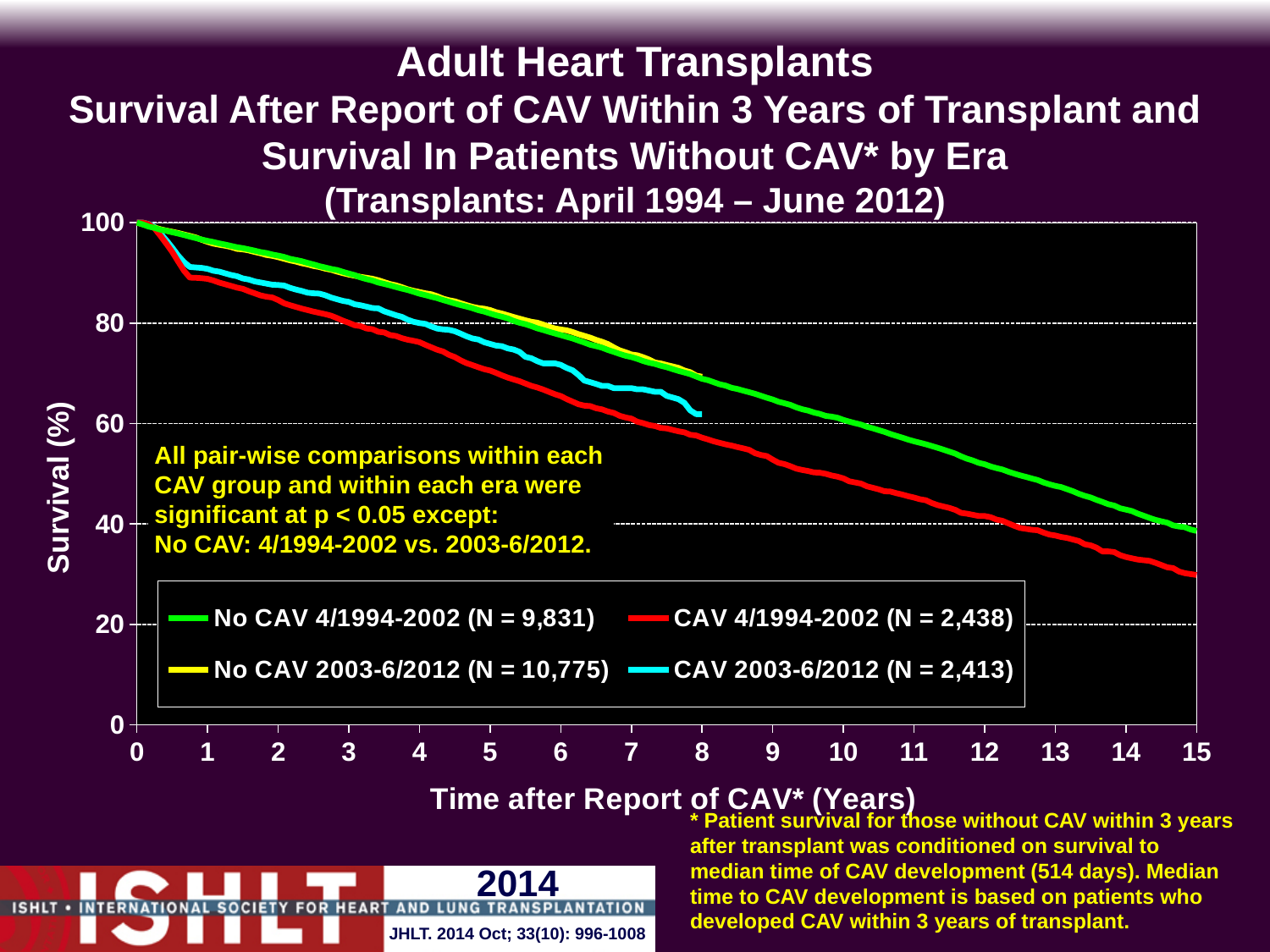
At 5 years, which series has the higher survival: CAV 2003-6/2012 or CAV 4/1994-2002? CAV 2003-6/2012 What is the N for the No CAV 2003-6/2012 series shown in the legend? 10,775 Is the survival value for CAV 4/1994-2002 at 5 years greater or less than 80? less What kind of chart is shown on the slide? line chart Is the survival value for CAV 4/1994-2002 at 15 years greater or less than 40? less Is the survival value for No CAV 4/1994-2002 at 5 years greater or less than 80? greater How many series does the legend list? 4 Do the survival curves rise or fall as time after report of CAV increases? fall What is the N for the CAV 4/1994-2002 series shown in the legend? 2,438 At 10 years, which series has the higher survival: No CAV 4/1994-2002 or CAV 4/1994-2002? No CAV 4/1994-2002 Which series has the lowest survival at 15 years? CAV 4/1994-2002